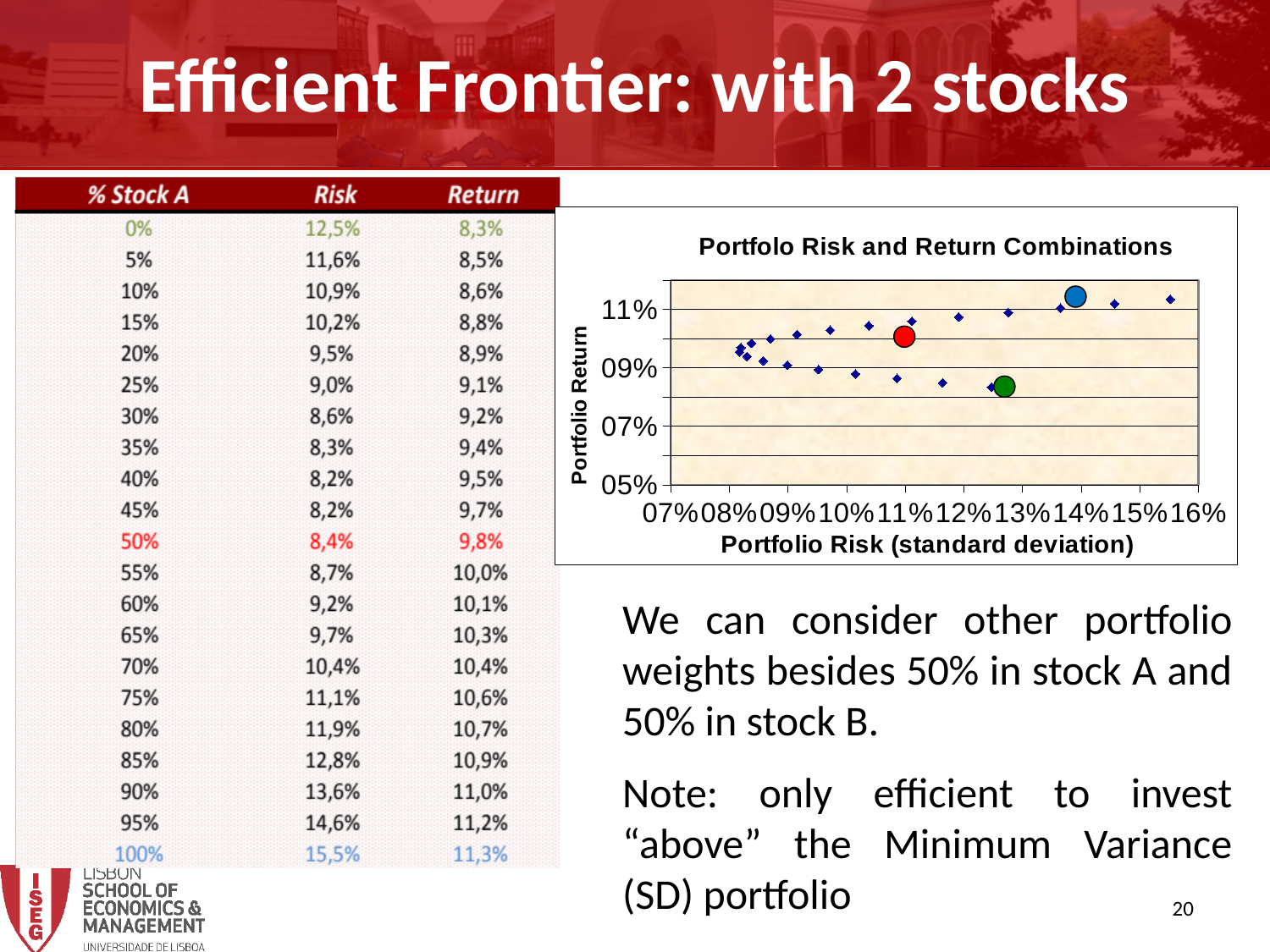
What is the title of the horizontal axis of the chart? Portfolio Risk (standard deviation) What kind of chart is shown on the slide? scatter chart Which highlighted point has the higher portfolio return, the blue one or the green one? the blue one Which highlighted point has the lower portfolio risk, the red one or the green one? the red one What is the title of the chart? Portfolo Risk and Return Combinations Of the three highlighted points (red, green, blue), which has the lowest portfolio return? the green one Is the portfolio risk of the green highlighted point greater or less than 12%? greater Is the portfolio return of the red highlighted point greater or less than 09%? greater Is the portfolio return of the green highlighted point greater or less than 09%? less Of the three highlighted points (red, green, blue), which has the highest portfolio risk? the blue one